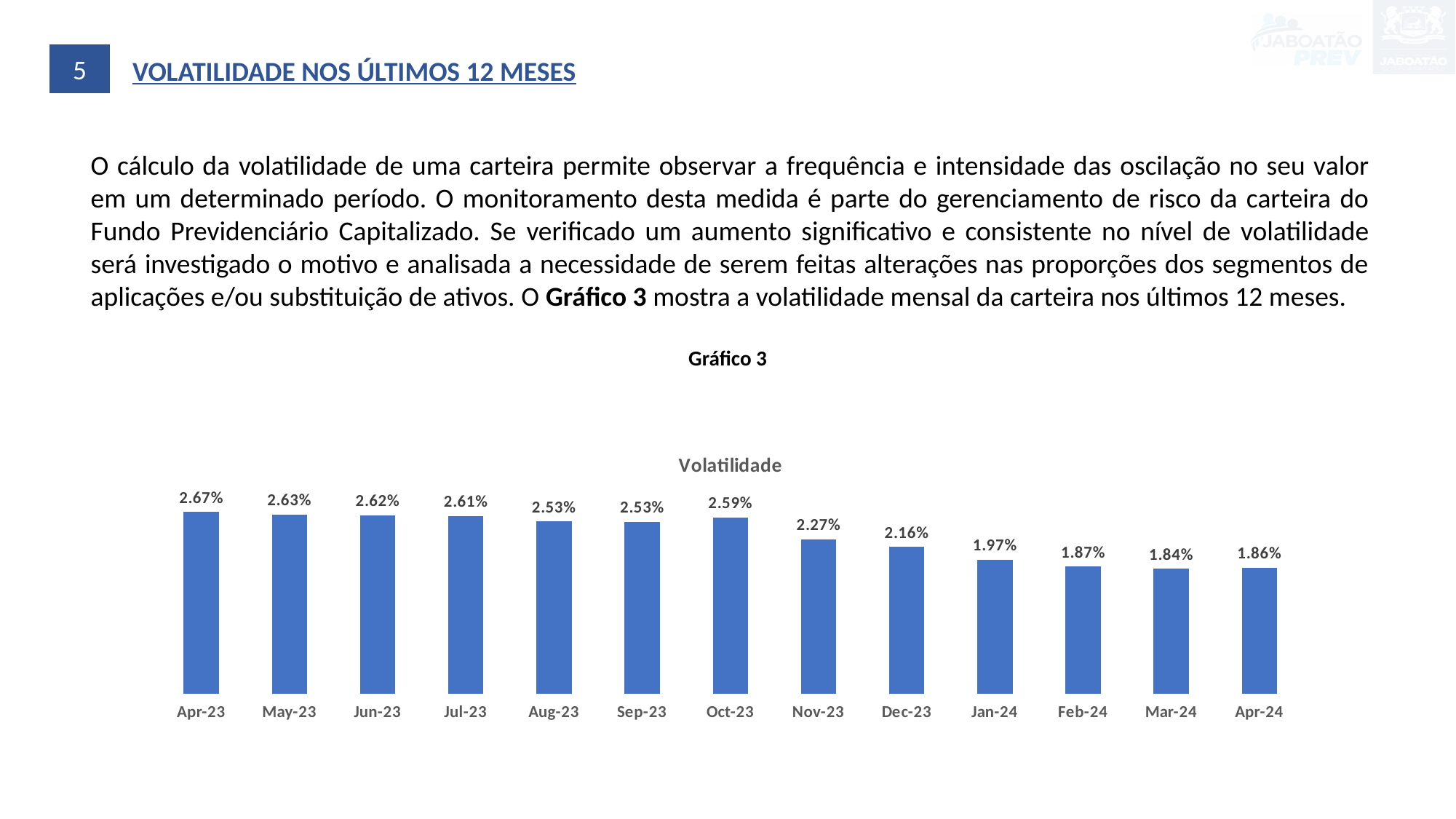
What is the volatility value for Apr-23? 2.67% What is the volatility value for Nov-23? 2.27% How many months are shown on the chart? 13 What is the title of the chart? Volatilidade Do the volatility values generally rise or fall from Apr-23 to Apr-24? Fall What is the difference between the volatility in Oct-23 and Nov-23? 0.32% What is the volatility value for Apr-24? 1.86% What is the difference between the volatility in Apr-23 and Apr-24? 0.81% Which month has the lowest volatility? Mar-24 Which month has the highest volatility? Apr-23 Which is larger, the volatility in Dec-23 or in Jan-24? Dec-23 What kind of chart is shown? Bar chart